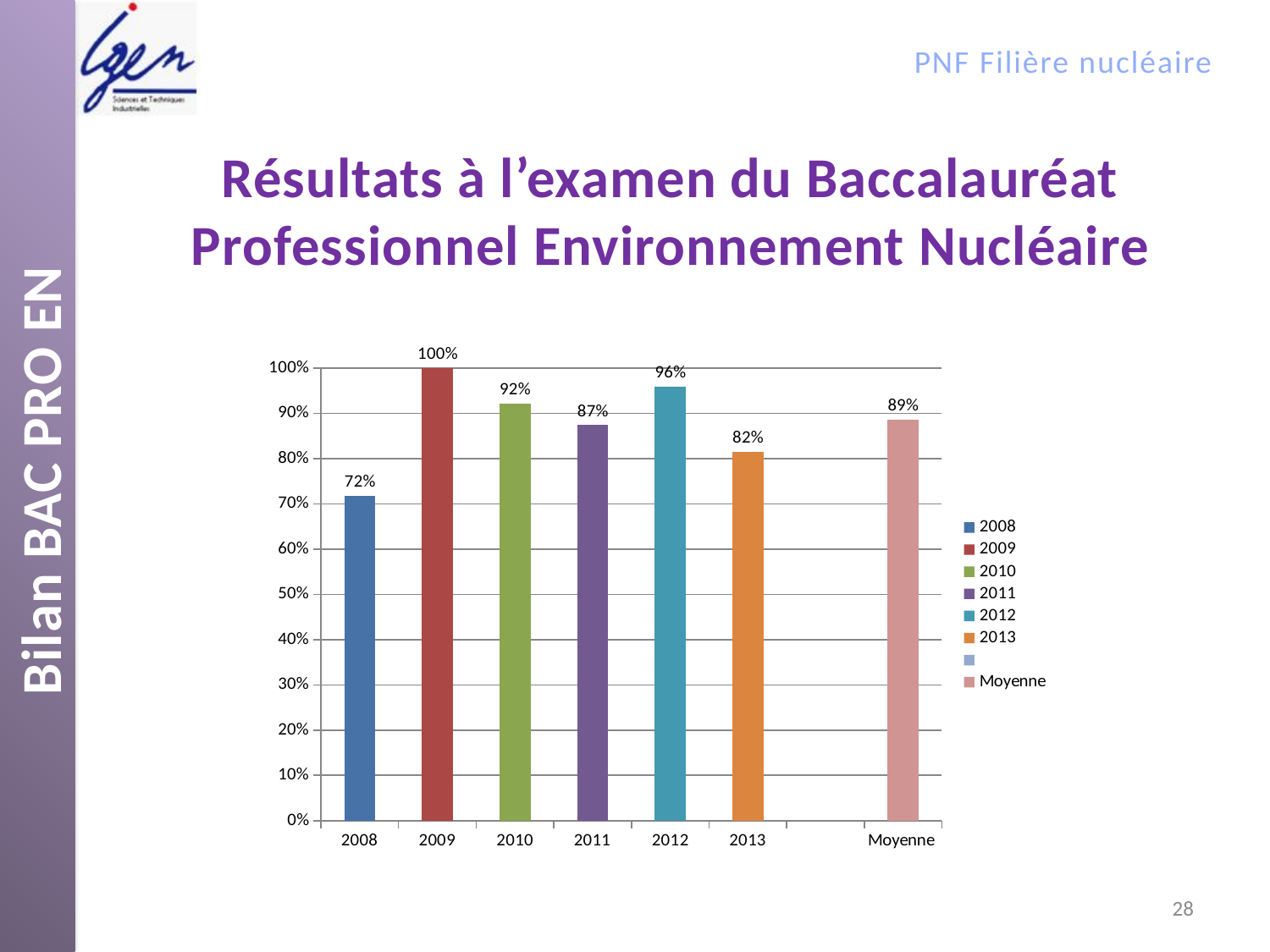
What is the difference between the values for 2009 and 2013? 18% What is the pass rate shown for 2008? 72% What is the value of the Moyenne bar? 89% Which is larger, the value for 2011 or the value for 2013? 2011 What is the difference between the values for 2010 and 2011? 5% What kind of chart is shown on the slide? bar chart How many bars are plotted on the chart? 7 What value is shown for 2012? 96% Which year has the highest value? 2009 Is the value for 2013 greater or less than 80%? greater Which year has the lowest value? 2008 What colour is the bar for 2009? red